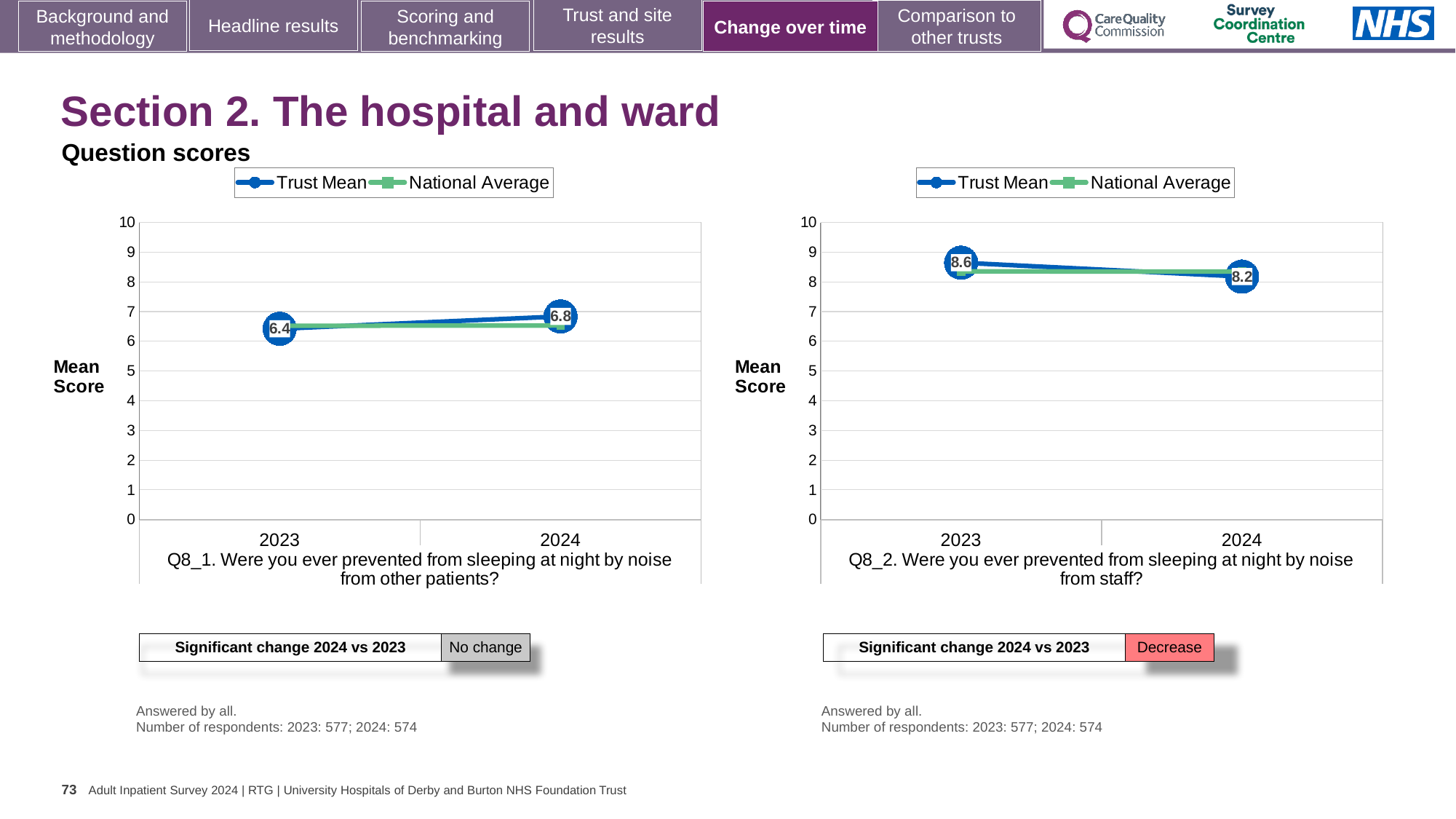
In the Q8_2 chart (right), what is the difference between the Trust Mean in 2023 and 2024? 0.4 In the Q8_2 chart (right), what is the Trust Mean score for 2023? 8.6 How many series does the legend of the Q8_2 chart (right) list? 2 In the Q8_1 chart (left), by how much did the Trust Mean change from 2023 to 2024? 0.4 In the Q8_2 chart (right), does the Trust Mean rise or fall from 2023 to 2024? fall What does the 'Significant change 2024 vs 2023' box under the Q8_2 chart (right) say? Decrease What kind of chart is the Q8_1 chart on the left? line chart In the Q8_1 chart (left), what is the Trust Mean score for 2024? 6.8 In the Q8_1 chart (left), is the National Average for 2023 greater or less than 5? greater In the Q8_1 chart (left), does the Trust Mean rise or fall from 2023 to 2024? rise In the Q8_2 chart (right), what is the Trust Mean score for 2024? 8.2 In the Q8_1 chart (left), what is the Trust Mean score for 2023? 6.4